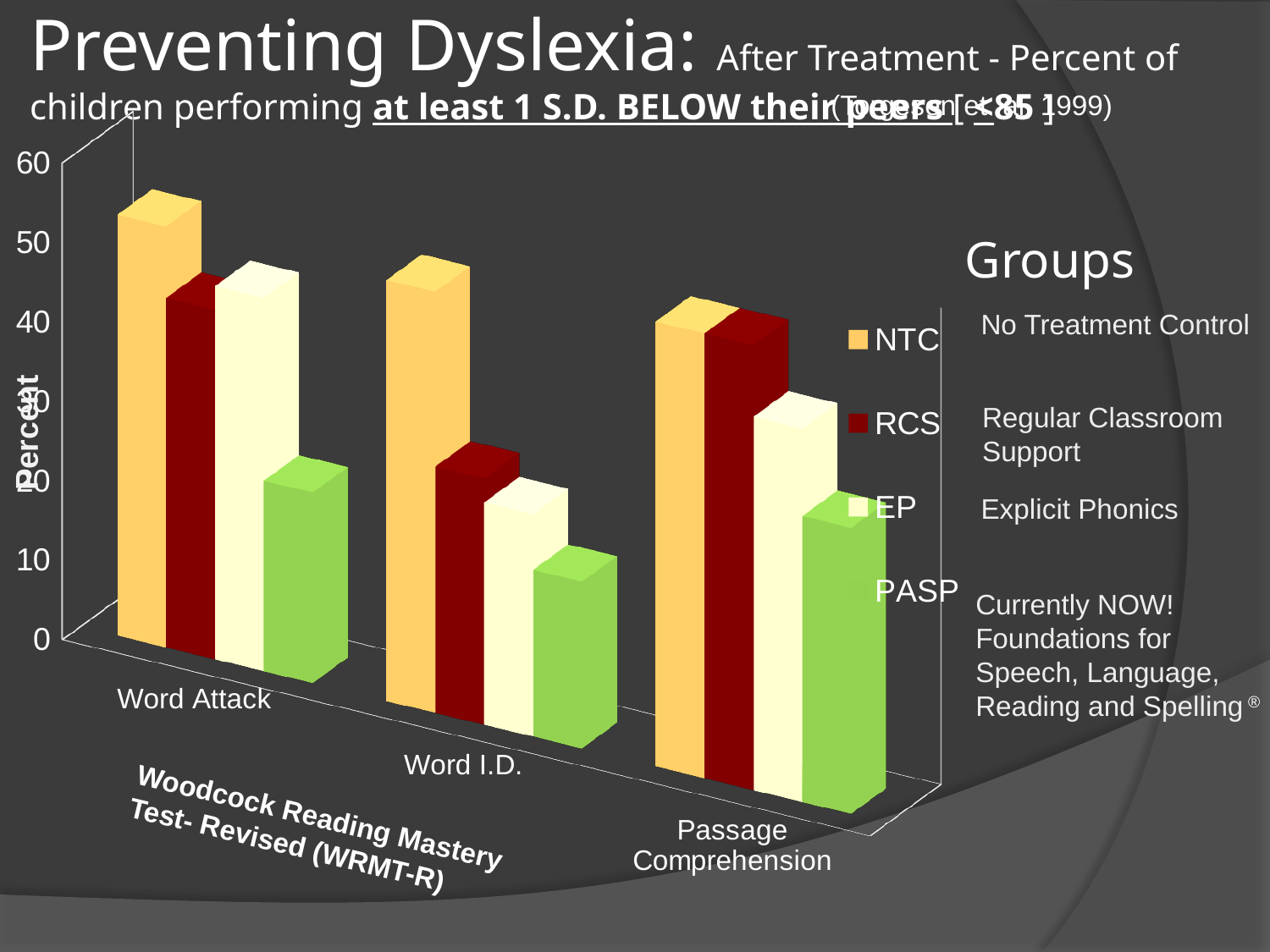
How many categories are shown along the x axis of the chart? 3 Is the value for NTC in Word Attack greater or less than 40? greater For Word I.D., which is larger: the NTC bar or the RCS bar? NTC Which group has the lowest bar for Passage Comprehension? PASP Is the value for NTC in Passage Comprehension greater or less than 30? greater Which group has the highest bar for Word Attack? NTC What kind of chart is shown on the slide? Bar chart Which group has the lowest bar for Word I.D.? PASP What is the title of the chart's vertical axis? Percent How many series does the chart's legend list? 4